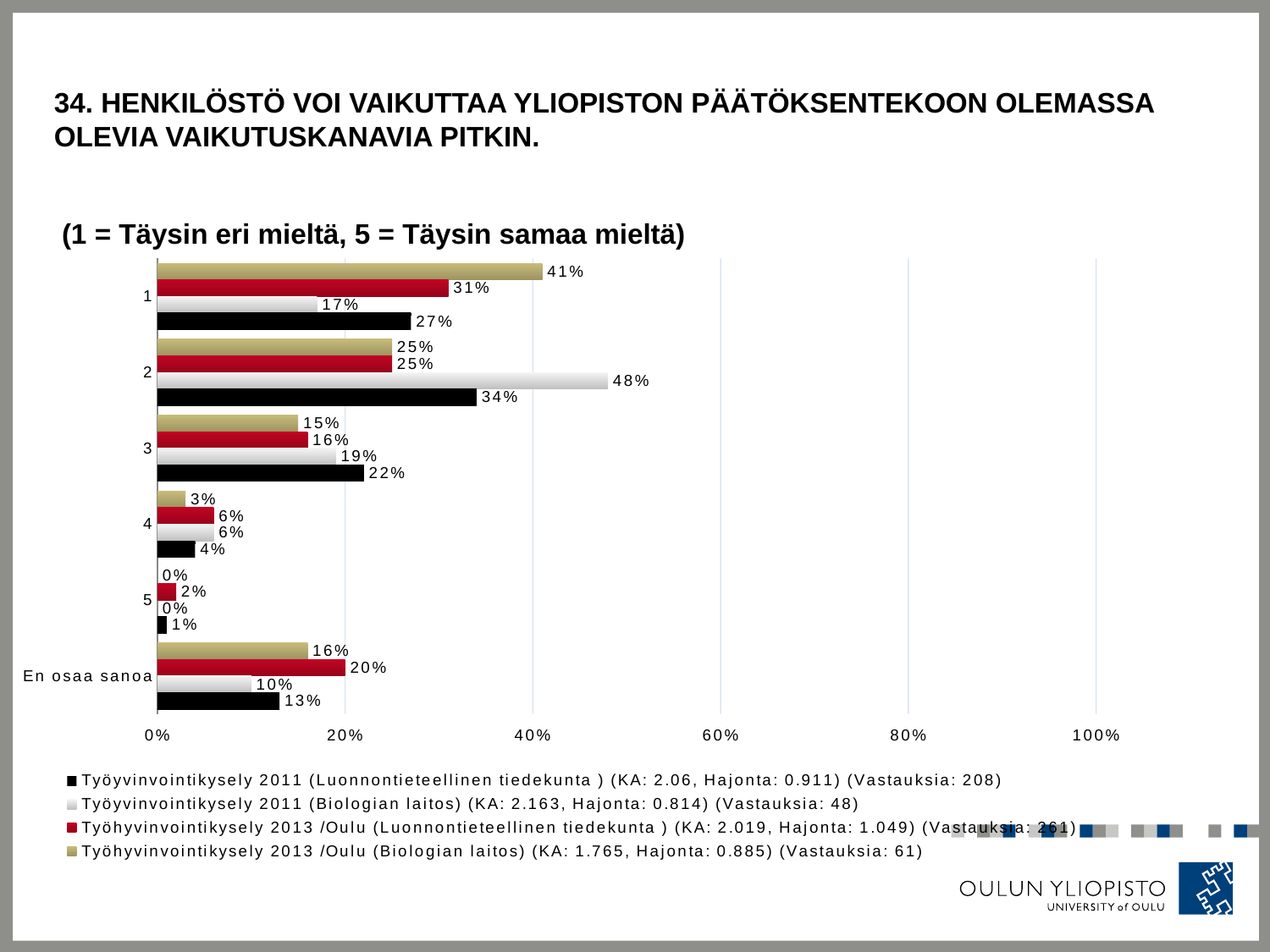
What is the value for category 1 in the Työhyvinvointikysely 2013 /Oulu (Biologian laitos) series? 41% What is the value for category 2 in the Työyvinvointikysely 2011 (Biologian laitos) series? 48% How many series does the legend list? 4 What kind of chart is shown on the slide? bar chart What is the difference between the Työhyvinvointikysely 2013 /Oulu (Biologian laitos) value and the Työyvinvointikysely 2011 (Biologian laitos) value for category 1? 24% For category 2, which is larger: the Työyvinvointikysely 2011 (Luonnontieteellinen tiedekunta ) value or the Työhyvinvointikysely 2013 /Oulu (Biologian laitos) value? Työyvinvointikysely 2011 (Luonnontieteellinen tiedekunta ) What is the value for category 3 in the Työyvinvointikysely 2011 (Luonnontieteellinen tiedekunta ) series? 22% How many categories are shown on the vertical axis of the chart? 6 Which category has the lowest value in the Työhyvinvointikysely 2013 /Oulu (Luonnontieteellinen tiedekunta ) series? 5 Is the value for category 2 in the Työyvinvointikysely 2011 (Biologian laitos) series greater or less than 40%? greater Which category has the highest value in the Työyvinvointikysely 2011 (Biologian laitos) series? 2 What is the value for 'En osaa sanoa' in the Työhyvinvointikysely 2013 /Oulu (Luonnontieteellinen tiedekunta ) series? 20%